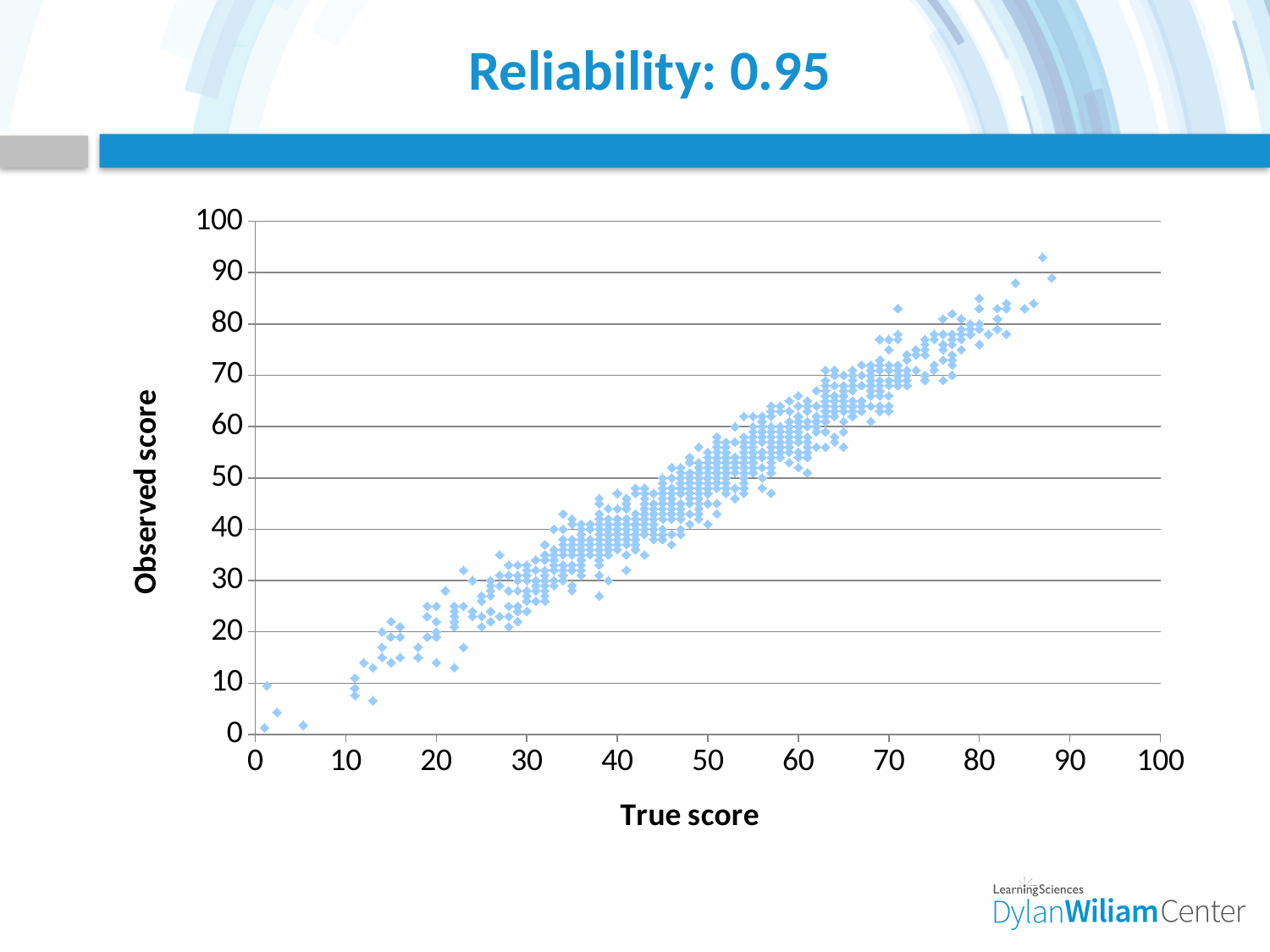
What is the interval between consecutive tick labels on the y axis? 10 What kind of chart is shown on the slide? scatter plot Is the highest observed score plotted greater or less than 90? greater As the true score increases along the x axis, do the observed scores generally rise or fall? rise What is the maximum value shown on the x axis (True score)? 100 What is the label of the x axis? True score What is the maximum value shown on the y axis (Observed score)? 100 For points with a true score of about 20, are the observed scores greater or less than 40? less What is the title of the slide/chart? Reliability: 0.95 Are there any points plotted with a true score greater than 90? no